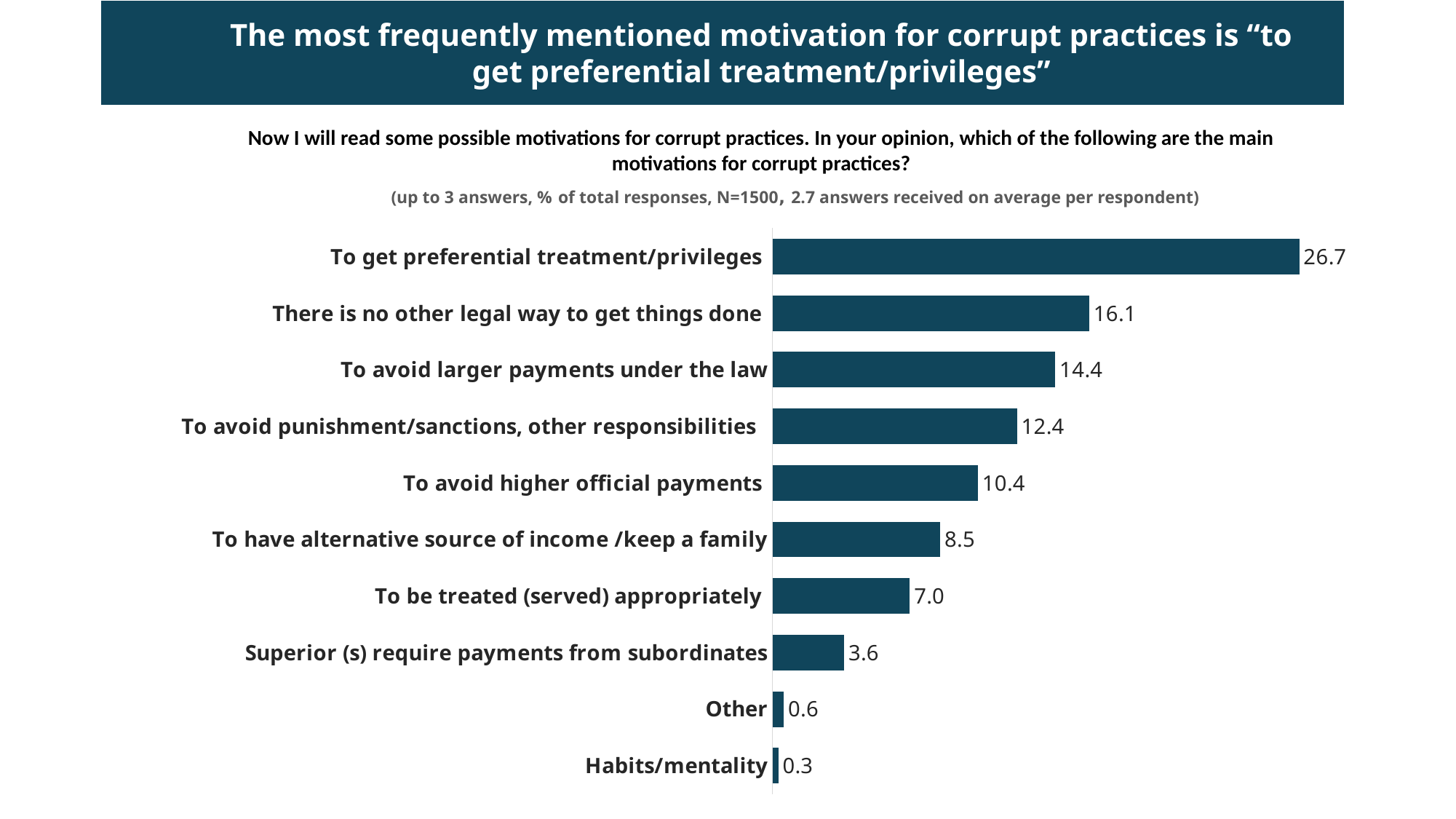
What is the sample size (N) stated in the chart subtitle? N=1500 How many categories are shown in the chart? 10 What is the value for "To get preferential treatment/privileges"? 26.7 Which category has the lowest value? Habits/mentality What kind of chart is shown on the slide? Bar chart What is the value for "To avoid higher official payments"? 10.4 Which category has the highest value? To get preferential treatment/privileges Which is larger: the value for "To have alternative source of income /keep a family" or the value for "To be treated (served) appropriately"? To have alternative source of income /keep a family What is the value for "Superior (s) require payments from subordinates"? 3.6 What is the value for "Other"? 0.6 What is the difference between the values for "To avoid larger payments under the law" and "To avoid punishment/sanctions, other responsibilities"? 2.0 What is the difference between the values for "To get preferential treatment/privileges" and "There is no other legal way to get things done"? 10.6